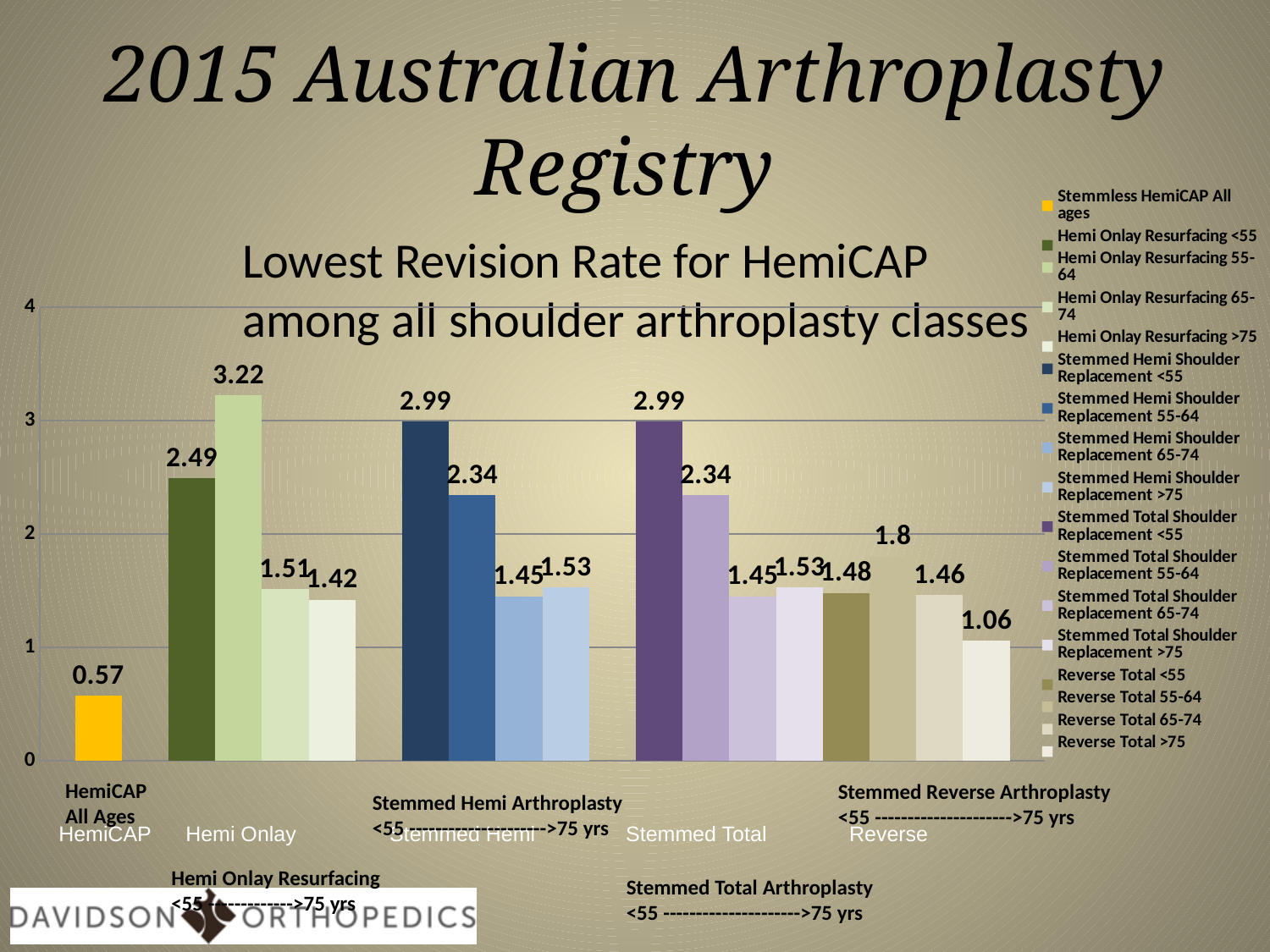
Which series has the lowest value on the chart? Stemmless HemiCAP All ages What is the revision rate shown for Stemmless HemiCAP All ages? 0.57 What is the value for Hemi Onlay Resurfacing 55-64? 3.22 How many series does the legend list? 17 How many categories are shown along the x axis? 5 What is the value for Reverse Total 55-64? 1.8 Which series has the highest value on the chart? Hemi Onlay Resurfacing 55-64 What is the difference between Hemi Onlay Resurfacing 55-64 and Stemmless HemiCAP All ages? 2.65 Is the value for Reverse Total 55-64 greater or less than 2? less What kind of chart is shown on the slide? Bar chart What is the value for Reverse Total >75? 1.06 Which is larger, Hemi Onlay Resurfacing <55 or Stemmed Hemi Shoulder Replacement <55? Stemmed Hemi Shoulder Replacement <55